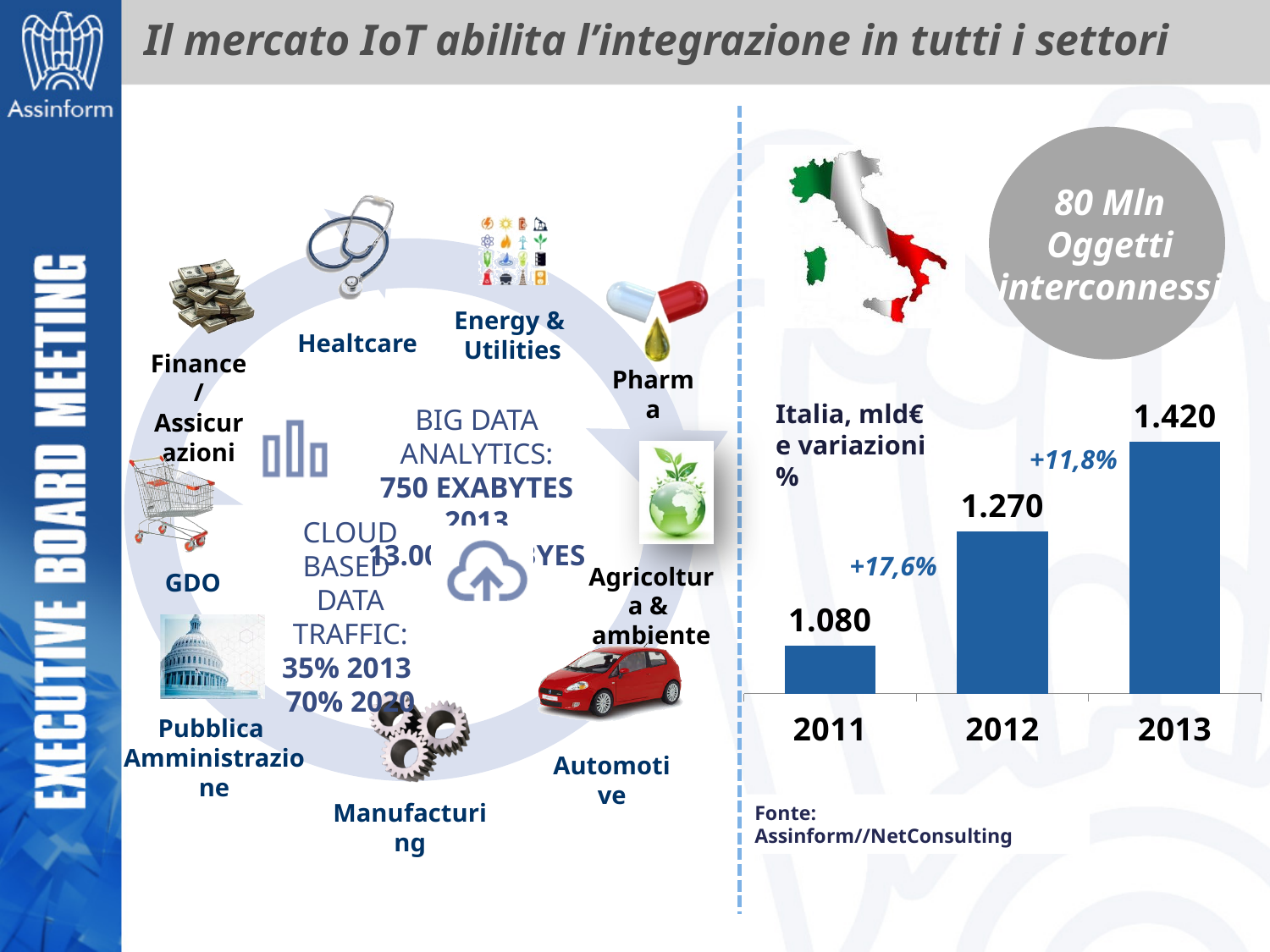
What percentage change is shown between 2011 and 2012 in the bar chart? +17,6% How many years are shown in the bar chart? 3 What is the difference between the 2012 and 2011 values in the bar chart? 190 Do the values in the bar chart rise or fall from 2011 to 2013? Rise What is the value for 2012 in the bar chart? 1.270 What kind of chart is shown on the right of the slide? Bar chart What is the value for 2013 in the bar chart? 1.420 Which is larger in the bar chart, the value for 2012 or the value for 2013? 2013 Which year has the highest value in the bar chart? 2013 Which year has the lowest value in the bar chart? 2011 What is the difference between the 2013 and 2011 values in the bar chart? 340 What is the value for 2011 in the bar chart? 1.080